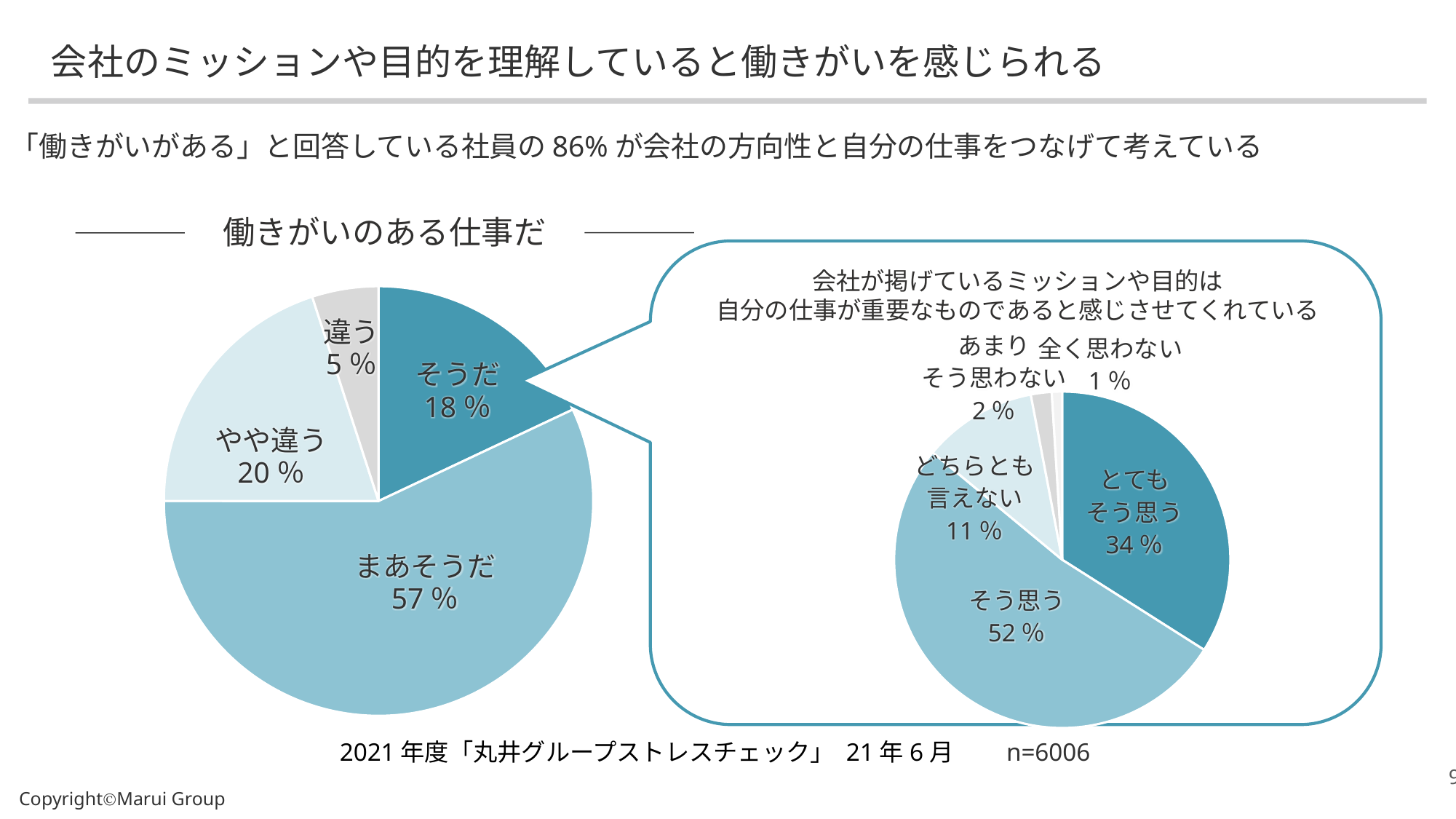
In the right pie chart (inside the speech bubble), what percentage is shown for 「どちらとも言えない」? 11 % In the right pie chart (inside the speech bubble), which category has the largest share? そう思う In the right pie chart (inside the speech bubble), what percentage is shown for 「とてもそう思う」? 34 % What type of chart is used on this slide? Pie chart In the left pie chart titled 「働きがいのある仕事だ」, what percentage is shown for 「まあそうだ」? 57 % In the left pie chart titled 「働きがいのある仕事だ」, what percentage is shown for 「違う」? 5 % In the right pie chart (inside the speech bubble), how many categories are shown? 5 In the left pie chart titled 「働きがいのある仕事だ」, how many categories are shown? 4 In the right pie chart (inside the speech bubble), which is larger, 「あまりそう思わない」 or 「全く思わない」? あまりそう思わない In the left pie chart titled 「働きがいのある仕事だ」, which category has the smallest share? 違う In the left pie chart titled 「働きがいのある仕事だ」, which category has the largest share? まあそうだ In the left pie chart titled 「働きがいのある仕事だ」, what is the difference in percentage points between 「まあそうだ」 and 「そうだ」? 39